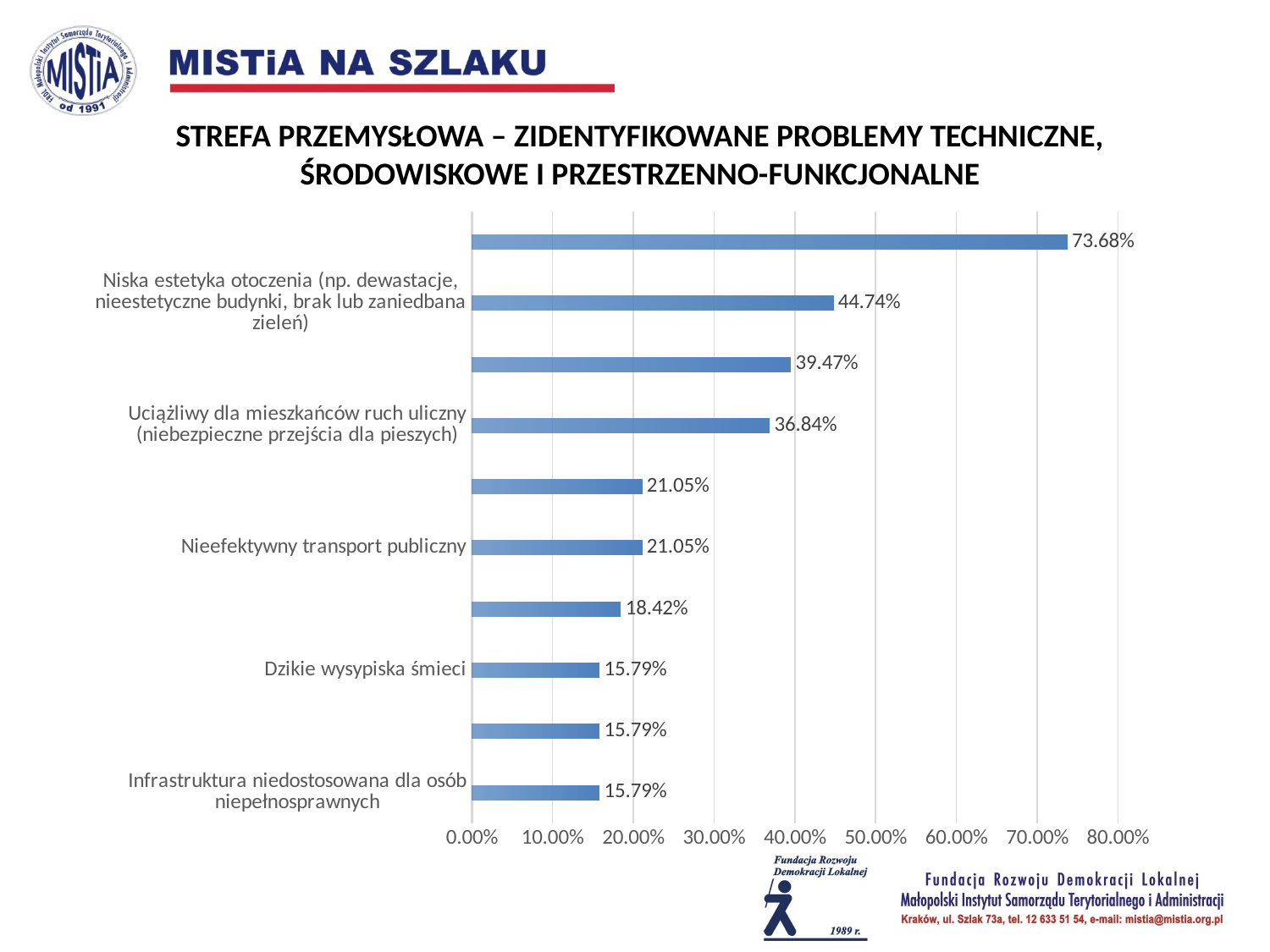
What is the value for "Dzikie wysypiska śmieci"? 15.79% How many bars are plotted on the chart? 10 What is the value for "Nieefektywny transport publiczny"? 21.05% What is the value for "Uciążliwy dla mieszkańców ruch uliczny (niebezpieczne przejścia dla pieszych)"? 36.84% Which is larger: the value for "Nieefektywny transport publiczny" or the value for "Dzikie wysypiska śmieci"? Nieefektywny transport publiczny What is the lowest value shown on the chart? 15.79% Is the value for "Uciążliwy dla mieszkańców ruch uliczny" greater or less than 30.00%? greater What is the highest value shown on the chart? 73.68% What kind of chart is shown on the slide? bar chart What is the value for "Infrastruktura niedostosowana dla osób niepełnosprawnych"? 15.79% What is the difference between the values for "Niska estetyka otoczenia" and "Uciążliwy dla mieszkańców ruch uliczny"? 7.90% What is the value for "Niska estetyka otoczenia (np. dewastacje, nieestetyczne budynki, brak lub zaniedbana zieleń)"? 44.74%